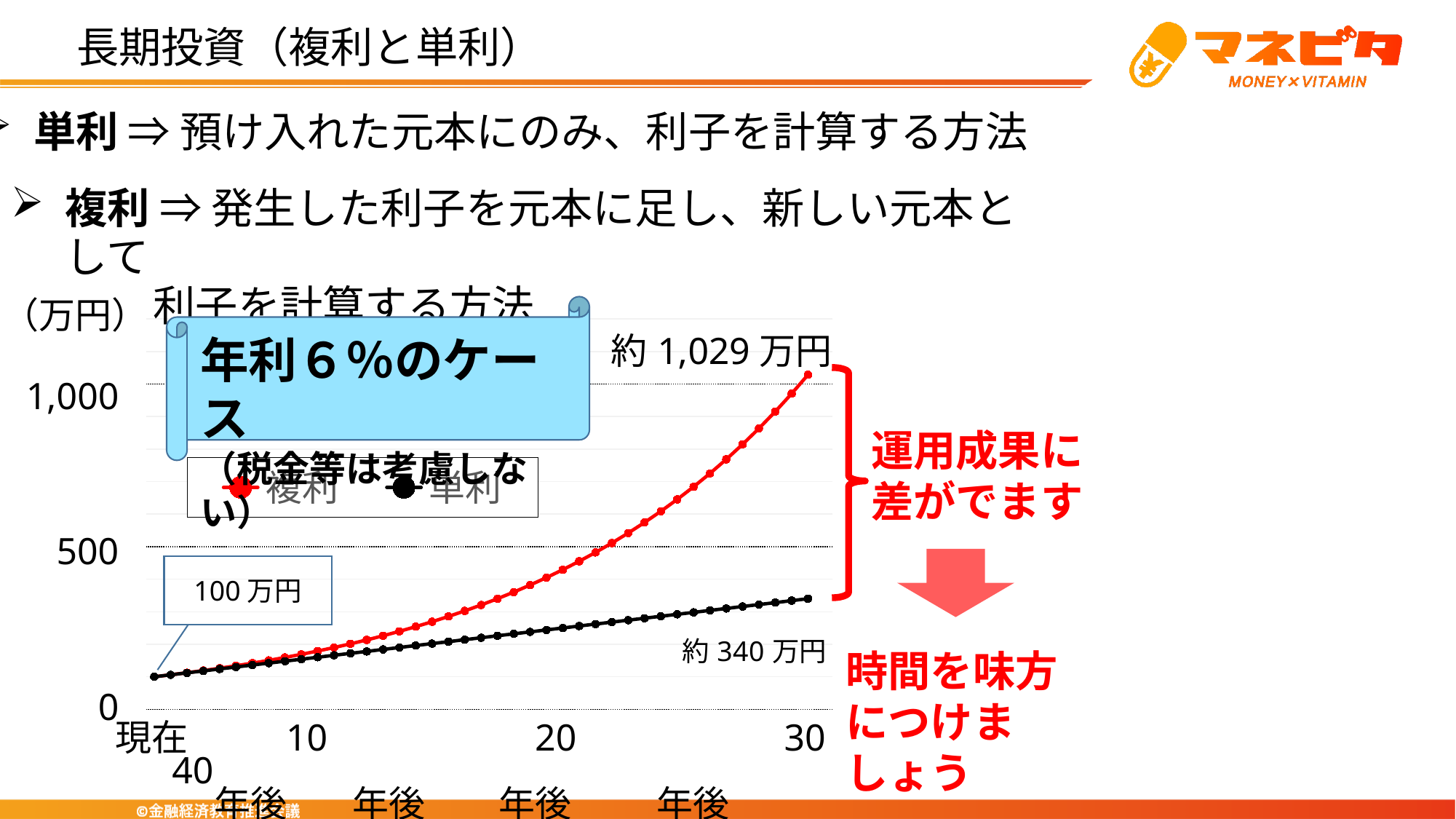
Is the value for 複利 at 20年後 greater or less than 500? less How many series does the chart's legend list? 2 What is the starting value (現在) shown on the chart? 100万円 Do the values of the 複利 series rise or fall as the years increase along the x axis? rise What are the two series named in the chart's legend? 複利 and 単利 What kind of chart is shown on the slide? line chart At 30年後, which series has the larger value, 複利 or 単利? 複利 What annual interest rate does the chart's case assume, according to the callout on the chart? 年利6% Is the value for 単利 at 30年後 greater or less than 500? less